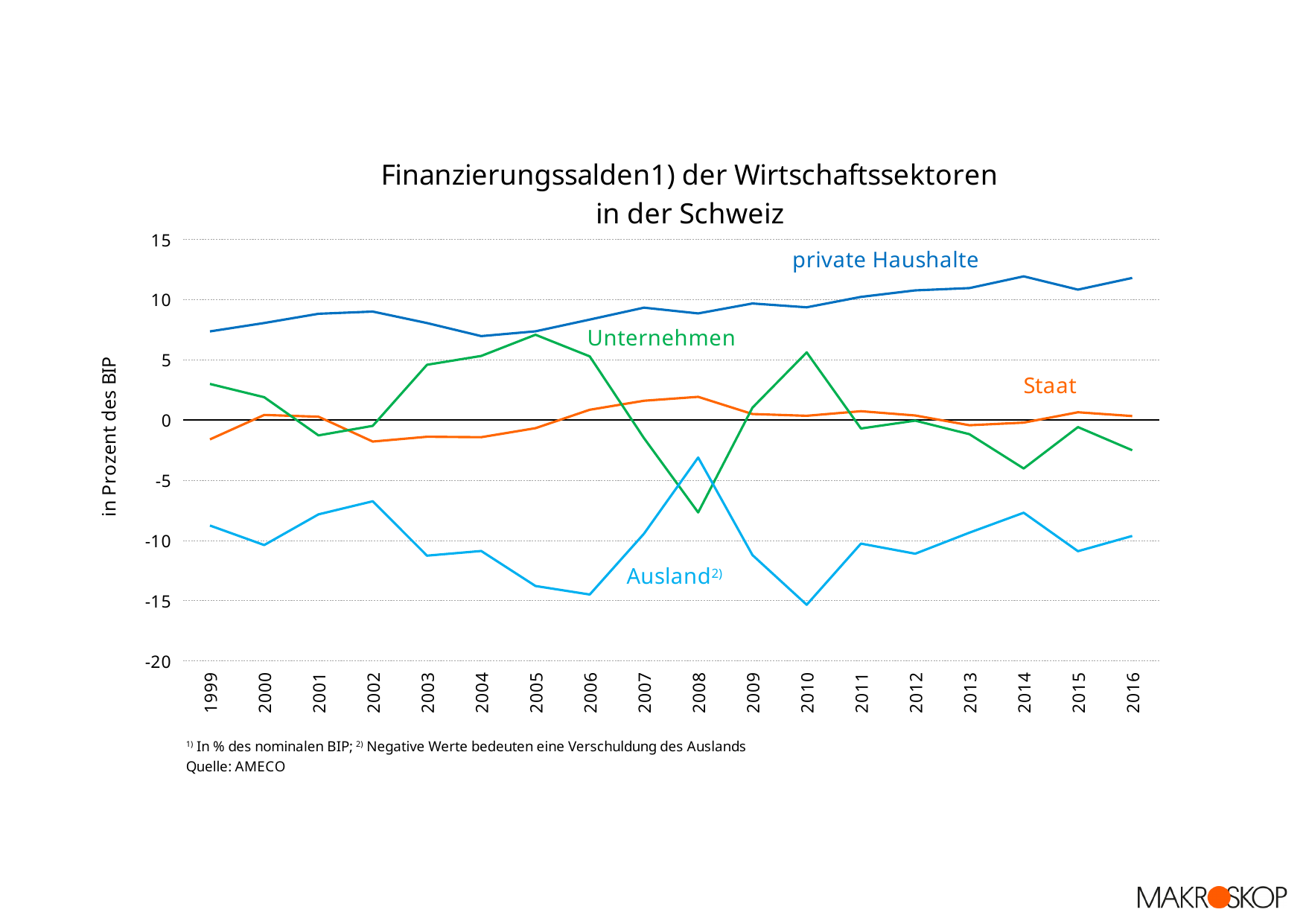
Is the value for private Haushalte in 2016 greater or less than 10? greater Is the value for Ausland in 2010 greater or less than -10? less Is the value for Unternehmen in 2008 greater or less than -5? less How many years are shown on the x axis of the chart? 18 How many series (sectors) are plotted in the chart? 4 In which year does the Unternehmen series reach its highest value? 2005 What kind of chart is shown on the slide? line chart What is the label of the y axis? in Prozent des BIP In which year does the Unternehmen series reach its lowest value? 2008 In 2010, which is larger: the value for Unternehmen or the value for Staat? Unternehmen Does the private Haushalte series rise or fall from 2009 to 2014? rise